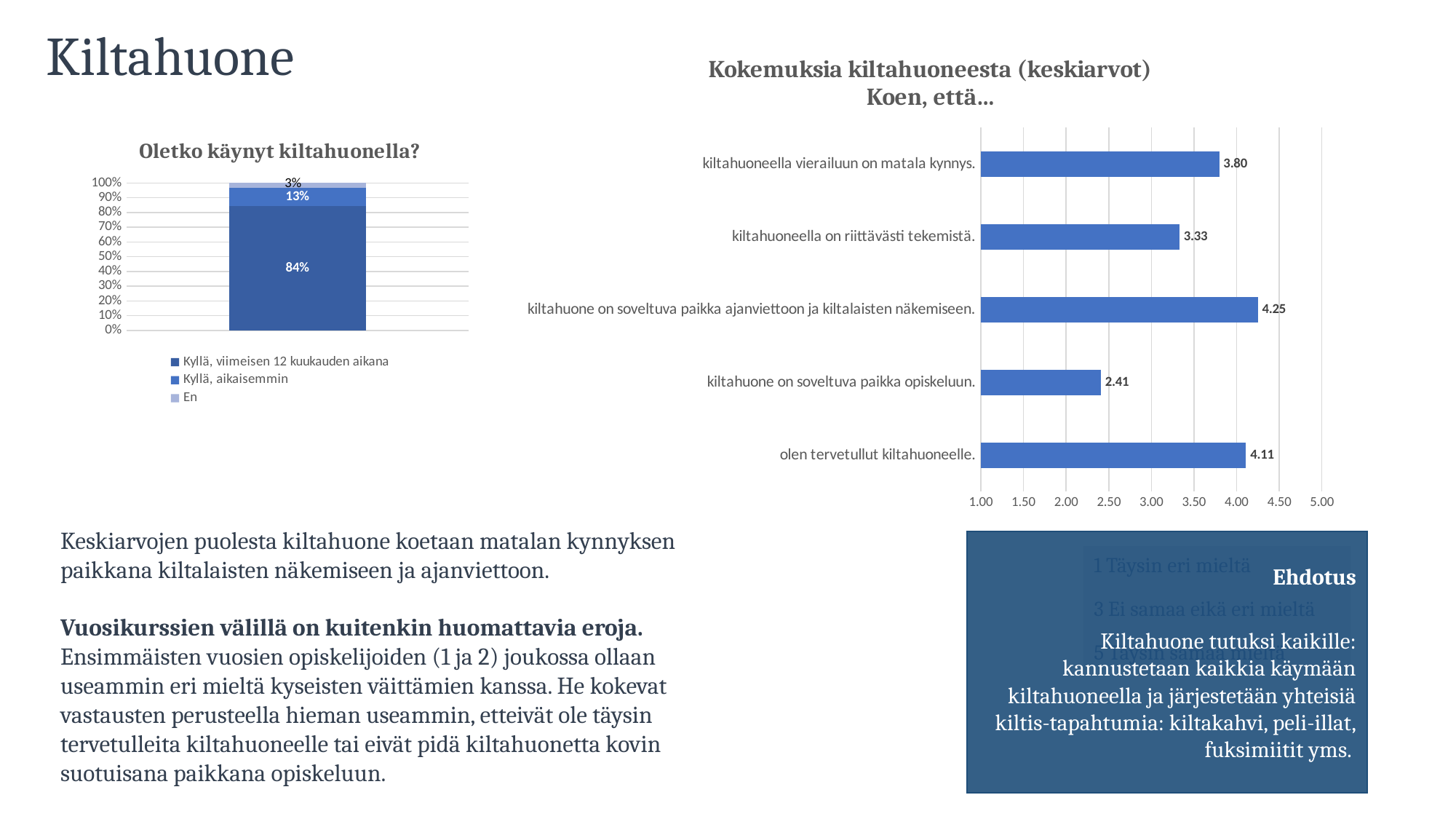
In the chart 'Kokemuksia kiltahuoneesta (keskiarvot)', which is larger: the value for 'olen tervetullut kiltahuoneelle.' or for 'kiltahuoneella vierailuun on matala kynnys.'? olen tervetullut kiltahuoneelle. What kind of chart is 'Kokemuksia kiltahuoneesta (keskiarvot)'? Bar chart In the chart 'Kokemuksia kiltahuoneesta (keskiarvot)', which statement has the highest value? kiltahuone on soveltuva paikka ajanviettoon ja kiltalaisten näkemiseen. In the chart 'Oletko käynyt kiltahuonella?', what is the value for 'Kyllä, viimeisen 12 kuukauden aikana'? 84% In the chart 'Kokemuksia kiltahuoneesta (keskiarvot)', which statement has the lowest value? kiltahuone on soveltuva paikka opiskeluun. In the chart 'Oletko käynyt kiltahuonella?', what is the difference between the values for 'Kyllä, viimeisen 12 kuukauden aikana' and 'Kyllä, aikaisemmin'? 71% In the chart 'Oletko käynyt kiltahuonella?', what is the value for 'En'? 3% In the chart 'Kokemuksia kiltahuoneesta (keskiarvot)', what is the value for 'kiltahuone on soveltuva paikka opiskeluun.'? 2.41 In the chart 'Kokemuksia kiltahuoneesta (keskiarvot)', what is the value for 'olen tervetullut kiltahuoneelle.'? 4.11 How many series does the legend of the chart 'Oletko käynyt kiltahuonella?' list? 3 In the chart 'Kokemuksia kiltahuoneesta (keskiarvot)', what is the difference between the values for 'kiltahuoneella vierailuun on matala kynnys.' and 'kiltahuoneella on riittävästi tekemistä.'? 0.47 How many statements are plotted in the chart 'Kokemuksia kiltahuoneesta (keskiarvot)'? 5